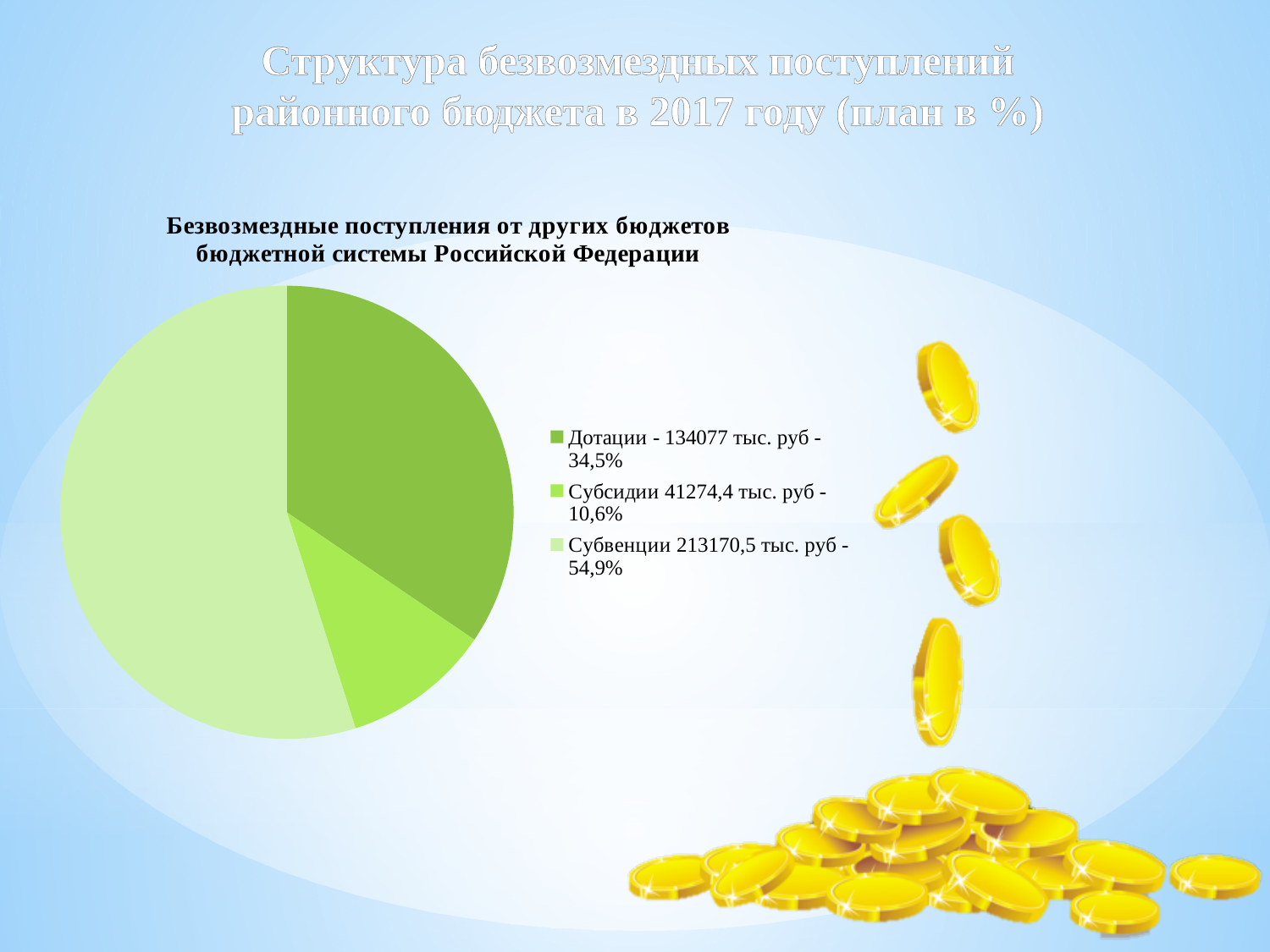
What share of the pie does Субсидии represent? 10,6% Which category has the largest share of the pie? Субвенции What share of the pie does Дотации represent? 34,5% How many slices does the pie chart have? 3 What share of the pie does Субвенции represent? 54,9% What kind of chart is shown on the slide? Pie chart What amount in тыс. руб is shown for Субвенции in the legend? 213170,5 тыс. руб Which is larger, the share for Дотации or the share for Субсидии? Дотации What is the difference in percentage points between the share for Субвенции and the share for Дотации? 20,4% What is the title of the pie chart? Безвозмездные поступления от других бюджетов бюджетной системы Российской Федерации Which category has the smallest share of the pie? Субсидии What amount in тыс. руб is shown for Дотации in the legend? 134077 тыс. руб